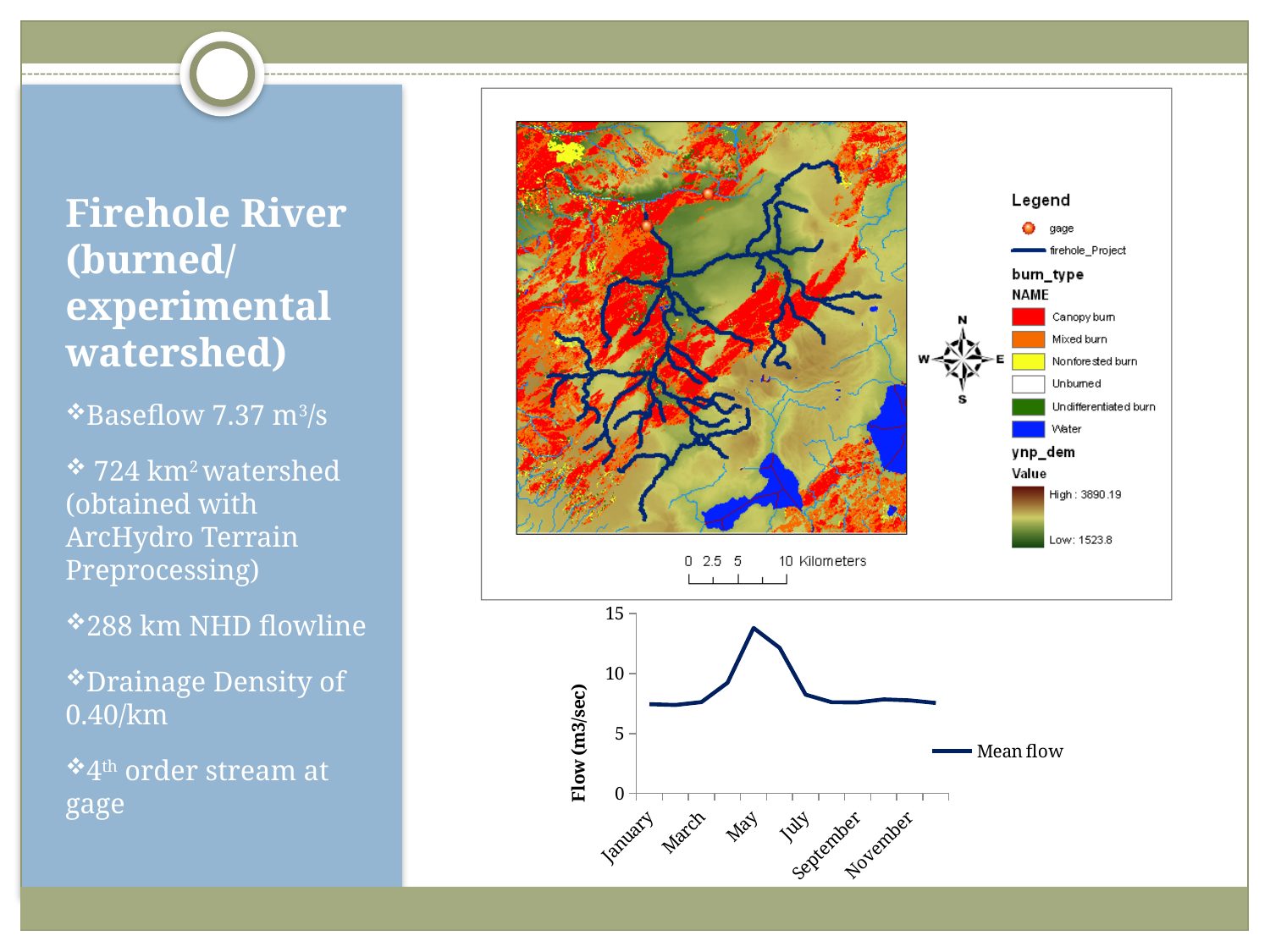
In the line chart, which has the larger mean flow, May or January? May In the line chart, is the mean flow for September greater or less than 5? greater What is the label of the y axis of the line chart? Flow (m3/sec) How many series does the legend of the line chart list? 1 What is the name of the series shown in the line chart's legend? Mean flow In the line chart, is the mean flow for May greater or less than 10? greater In the line chart, is the mean flow for January greater or less than 10? less In the line chart, does the mean flow rise or fall from May to July? fall In the line chart, in which month is the mean flow highest? May How many month labels are printed on the x axis of the line chart? 6 What kind of chart is the chart below the map? line chart In the line chart, does the mean flow rise or fall from March to May? rise